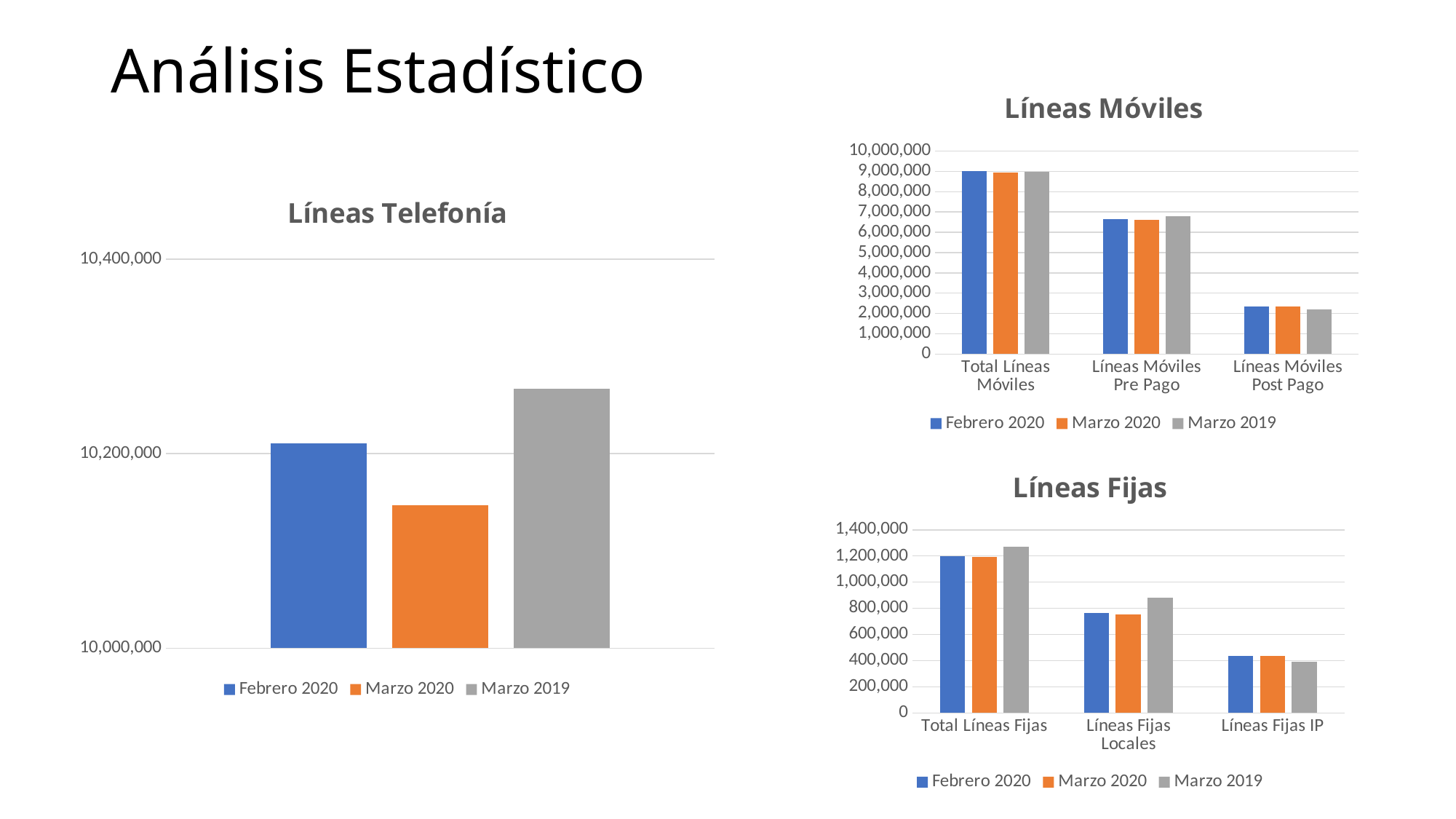
How many series does the legend of the Líneas Móviles chart list? 3 In the Líneas Móviles chart, which category has the lowest values? Líneas Móviles Post Pago In the Líneas Telefonía chart, which series has the lowest bar? Marzo 2020 In the Líneas Telefonía chart, is the value for Marzo 2019 greater or less than 10,200,000? greater In the Líneas Fijas chart, is the Marzo 2019 value for Líneas Fijas Locales greater or less than 800,000? greater How many categories are shown on the x axis of the Líneas Fijas chart? 3 In the Líneas Móviles chart, is the Marzo 2019 value for Líneas Móviles Post Pago greater or less than 3,000,000? less In the Líneas Telefonía chart, which series has the highest bar? Marzo 2019 What type of chart is the Líneas Fijas chart? Bar chart In the Líneas Fijas chart, which series has the highest bar for Líneas Fijas Locales? Marzo 2019